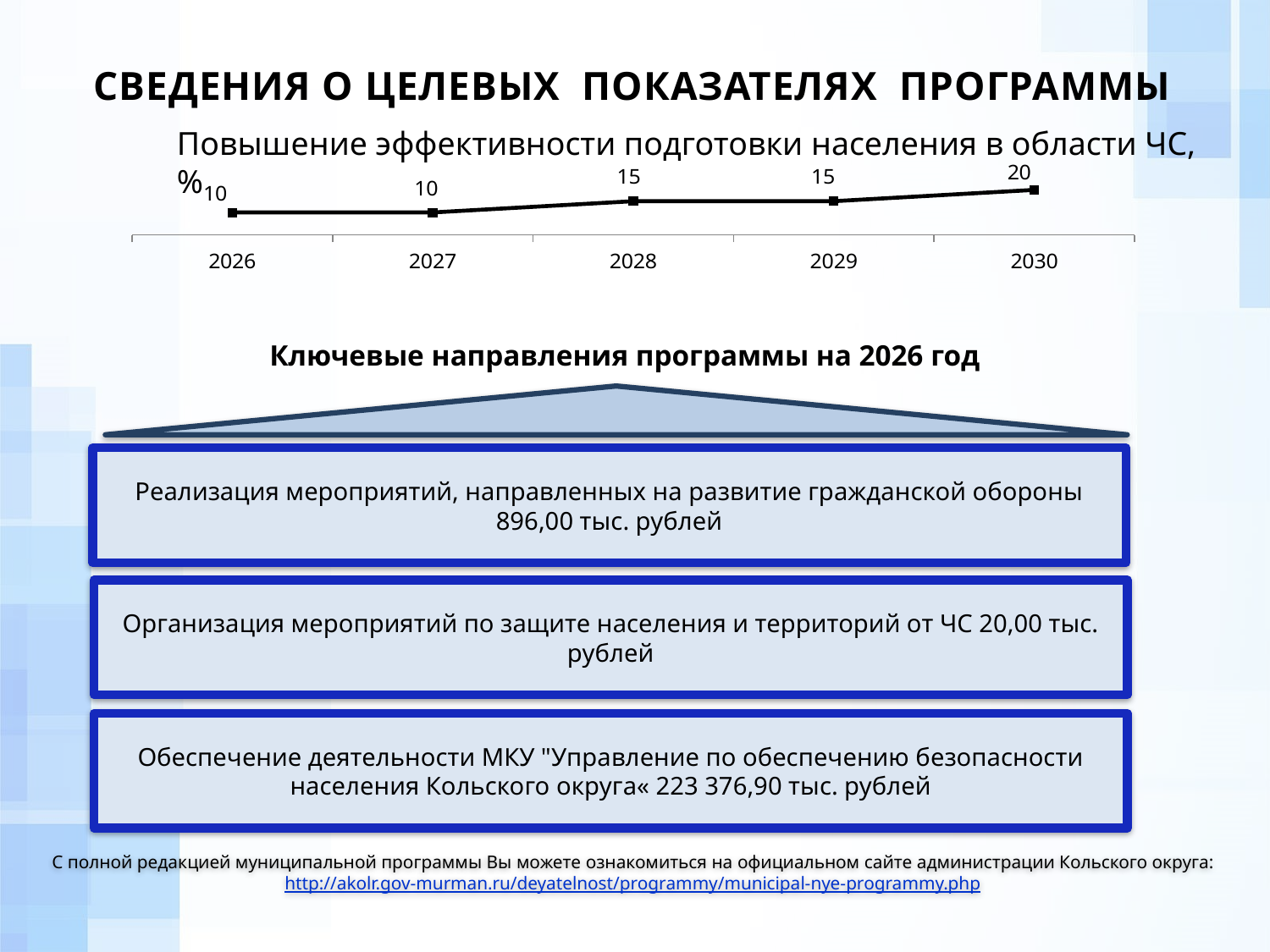
What is the title of the line chart? Повышение эффективности подготовки населения в области ЧС, % Which year has the highest value on the line chart? 2030 What kind of chart is shown on the slide? line chart What is the difference between the values for 2028 and 2027 on the line chart? 5 How many data points are plotted on the line chart? 5 Do the values on the line chart rise or fall from 2026 to 2030? rise What is the value for 2026 on the line chart? 10 What is the value for 2030 on the line chart? 20 What is the difference between the values for 2030 and 2026 on the line chart? 10 Which is larger on the line chart, the value for 2029 or the value for 2030? 2030 What is the value for 2028 on the line chart? 15 Which years on the line chart share the same value of 15? 2028 and 2029